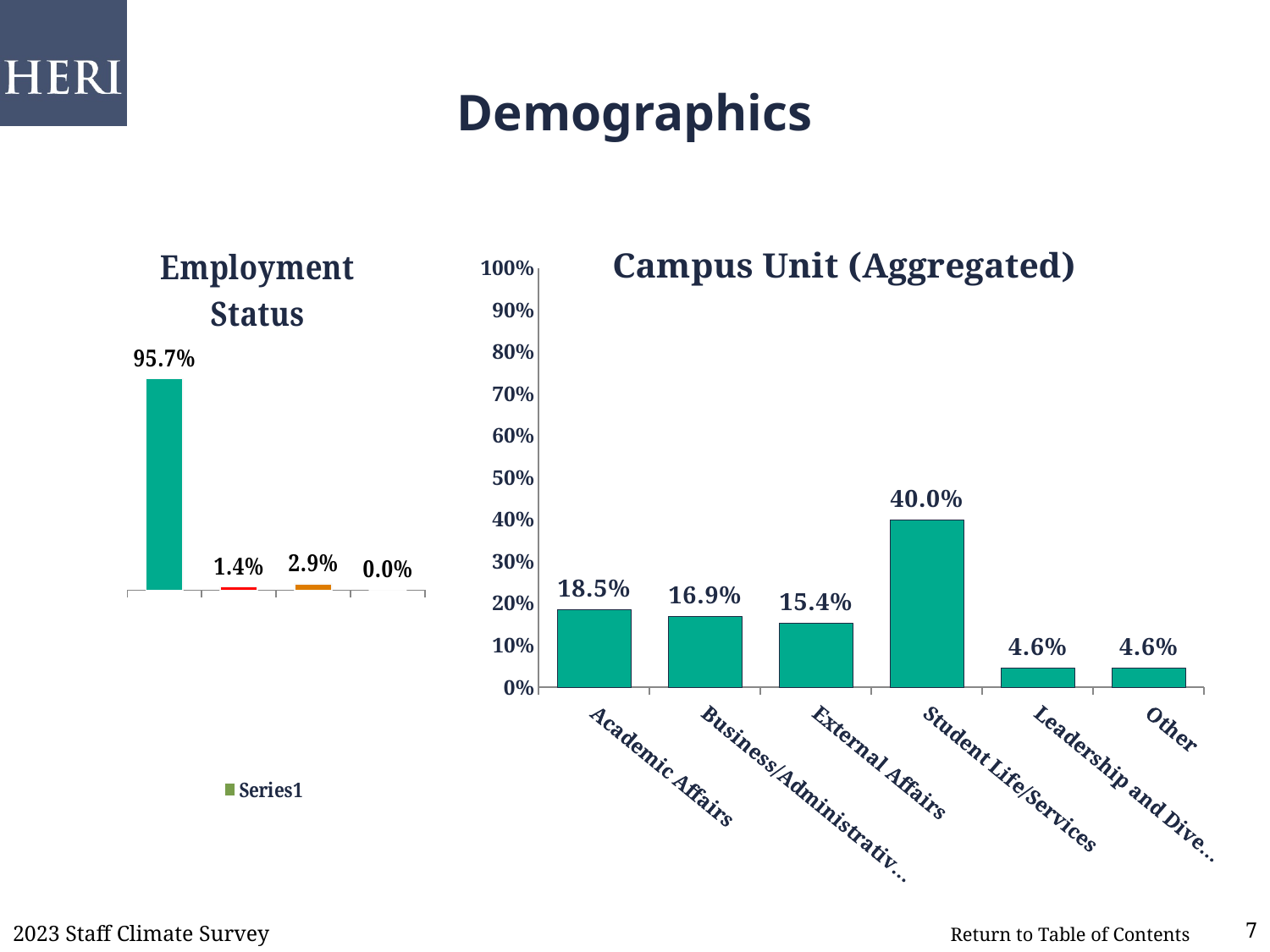
What series name does the legend of the Employment Status chart show? Series1 In the Campus Unit (Aggregated) chart, which is larger, Academic Affairs or External Affairs? Academic Affairs In the Campus Unit (Aggregated) chart, what is the value for External Affairs? 15.4% How many categories are shown in the Campus Unit (Aggregated) chart? 6 In the Campus Unit (Aggregated) chart, what is the value for Other? 4.6% In the Campus Unit (Aggregated) chart, what is the value for Student Life/Services? 40.0% In the Campus Unit (Aggregated) chart, which category has the highest value? Student Life/Services In the Employment Status chart, what is the highest value shown? 95.7% In the Campus Unit (Aggregated) chart, is the value for Student Life/Services greater or less than 30%? greater In the Campus Unit (Aggregated) chart, what is the difference between Student Life/Services and Academic Affairs? 21.5% In the Campus Unit (Aggregated) chart, what is the value for Academic Affairs? 18.5% What kind of chart is the Campus Unit (Aggregated) chart? Bar chart